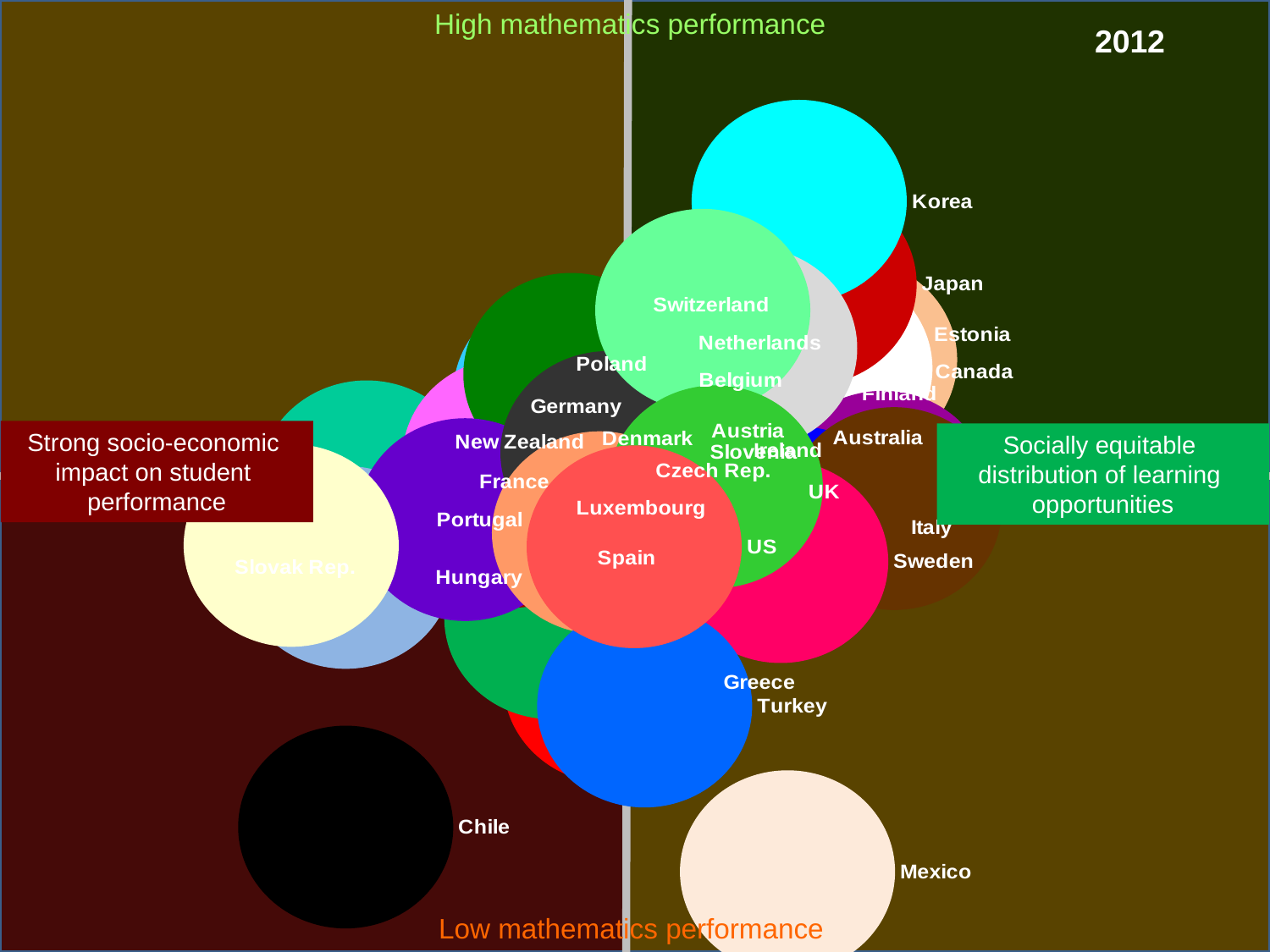
What label appears at the top of the chart's vertical axis? High mathematics performance Which country is plotted higher on the chart, Chile or Switzerland? Switzerland What year is shown in the top-right corner of the chart? 2012 Which country's bubble is positioned furthest to the left on the chart? Slovak Rep. What kind of chart is shown on the slide? Bubble chart Which country is plotted further to the right on the chart, Chile or Australia? Australia Which country's bubble is positioned lowest on the chart, indicating the lowest mathematics performance? Mexico Which country is plotted higher on the chart, Korea or Mexico? Korea In which quadrant of the chart is Chile located: high or low mathematics performance, and strong socio-economic impact or socially equitable? Low mathematics performance, strong socio-economic impact In which quadrant of the chart is Korea located? High mathematics performance, socially equitable distribution of learning opportunities Which country's bubble is positioned highest on the chart, indicating the highest mathematics performance? Korea